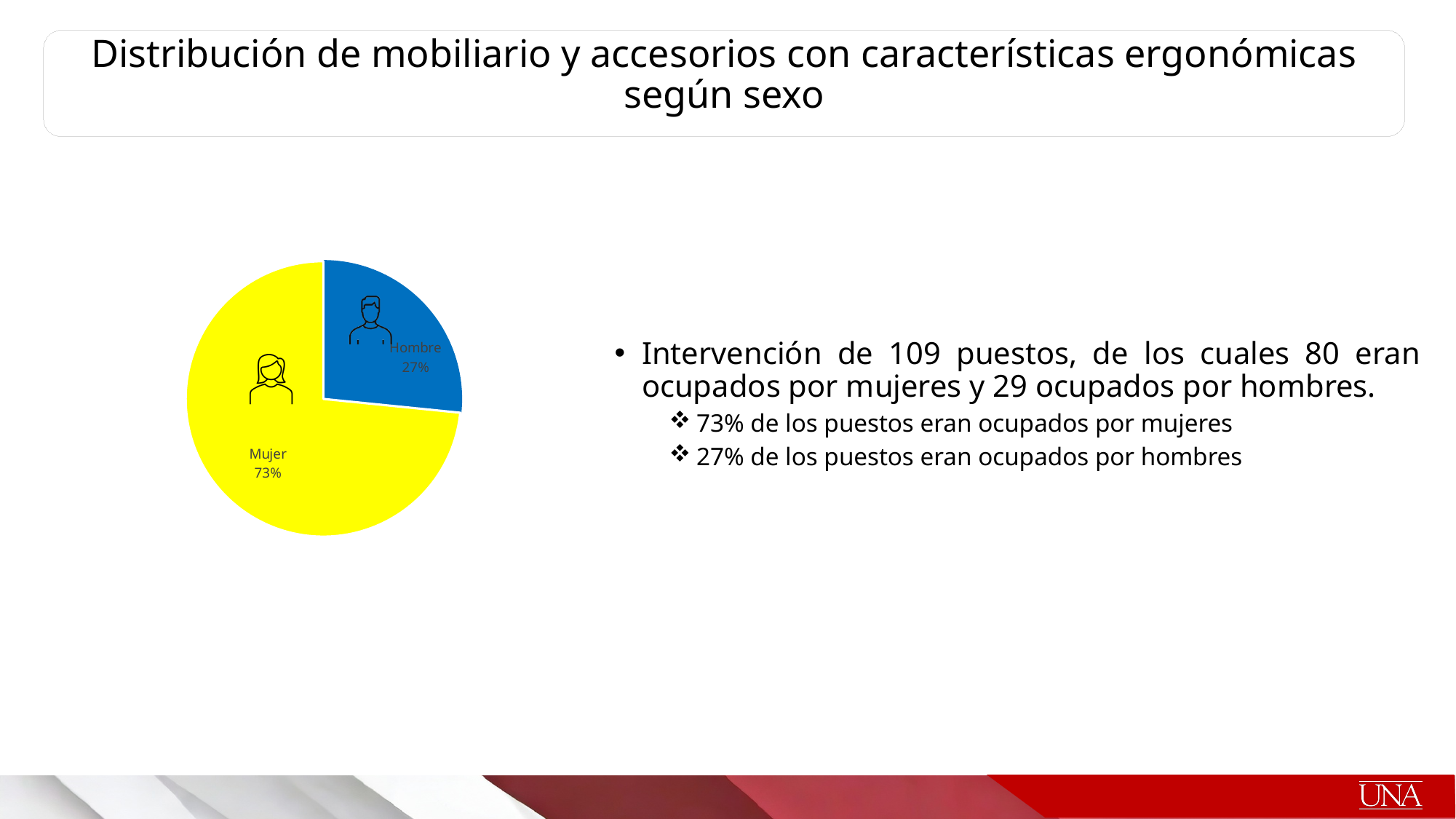
What colour is the Hombre slice? blue What percentage does the Hombre slice show? 27% What kind of chart is shown on the slide? pie chart What colour is the Mujer slice? yellow What share of the pie does the Hombre slice represent? 27% What percentage does the Mujer slice show? 73% Which slice is larger, Mujer or Hombre? Mujer What is the difference in percentage points between the Mujer and Hombre slices? 46 Which slice of the pie is the smallest? Hombre How many slices does the pie chart have? 2 Which slice of the pie is the largest? Mujer